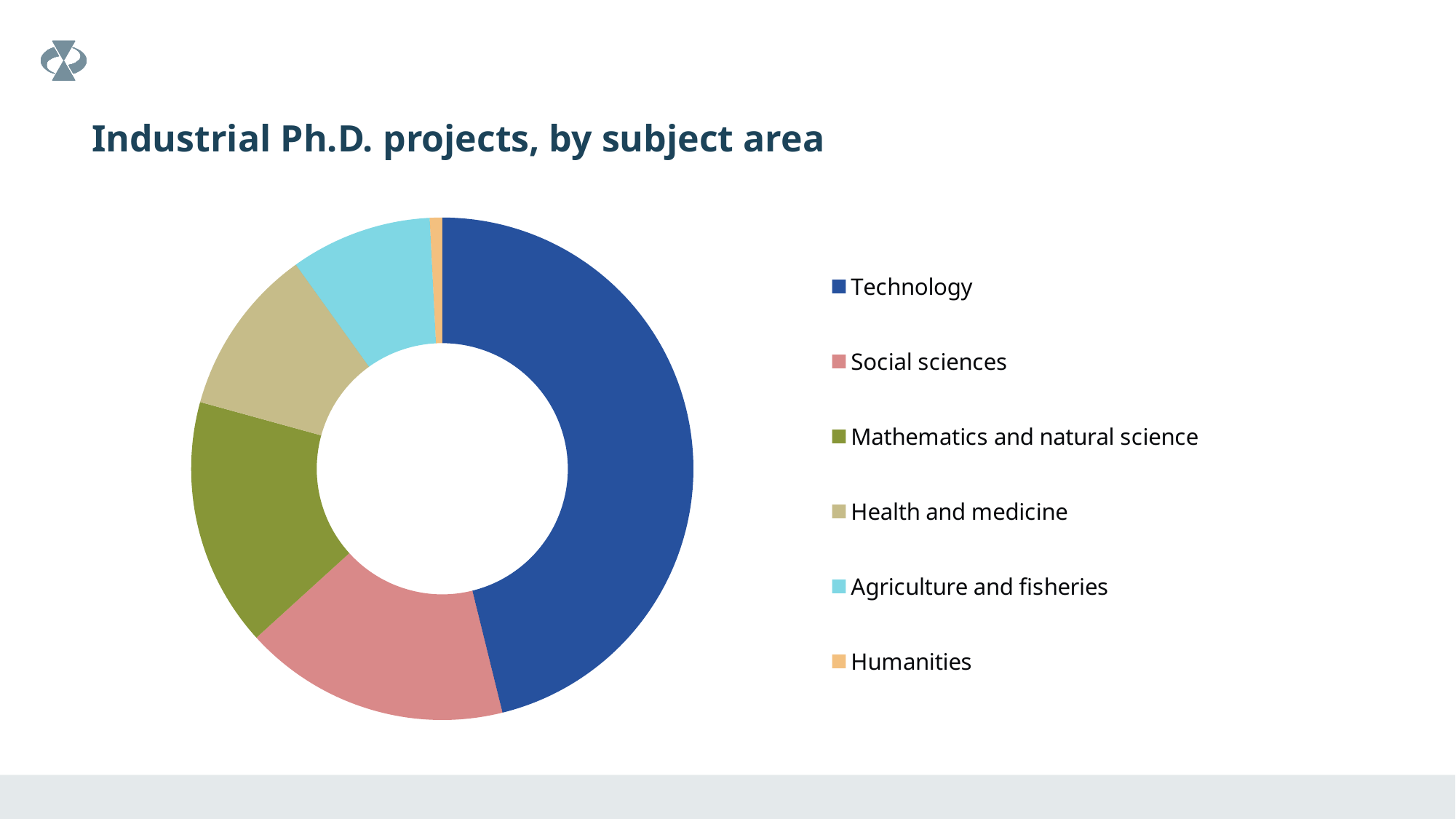
Which has a larger share, Technology or Social sciences? Technology Which has a larger share, Mathematics and natural science or Agriculture and fisheries? Mathematics and natural science What kind of chart is shown on the slide? Doughnut (pie) chart Which subject area is shown in dark blue? Technology Does Technology account for more or less than half of the chart? Less Which subject area has the smallest share of industrial Ph.D. projects? Humanities Which subject area has the largest share of industrial Ph.D. projects? Technology What is the title of the chart? Industrial Ph.D. projects, by subject area How many subject areas does the chart show? 6